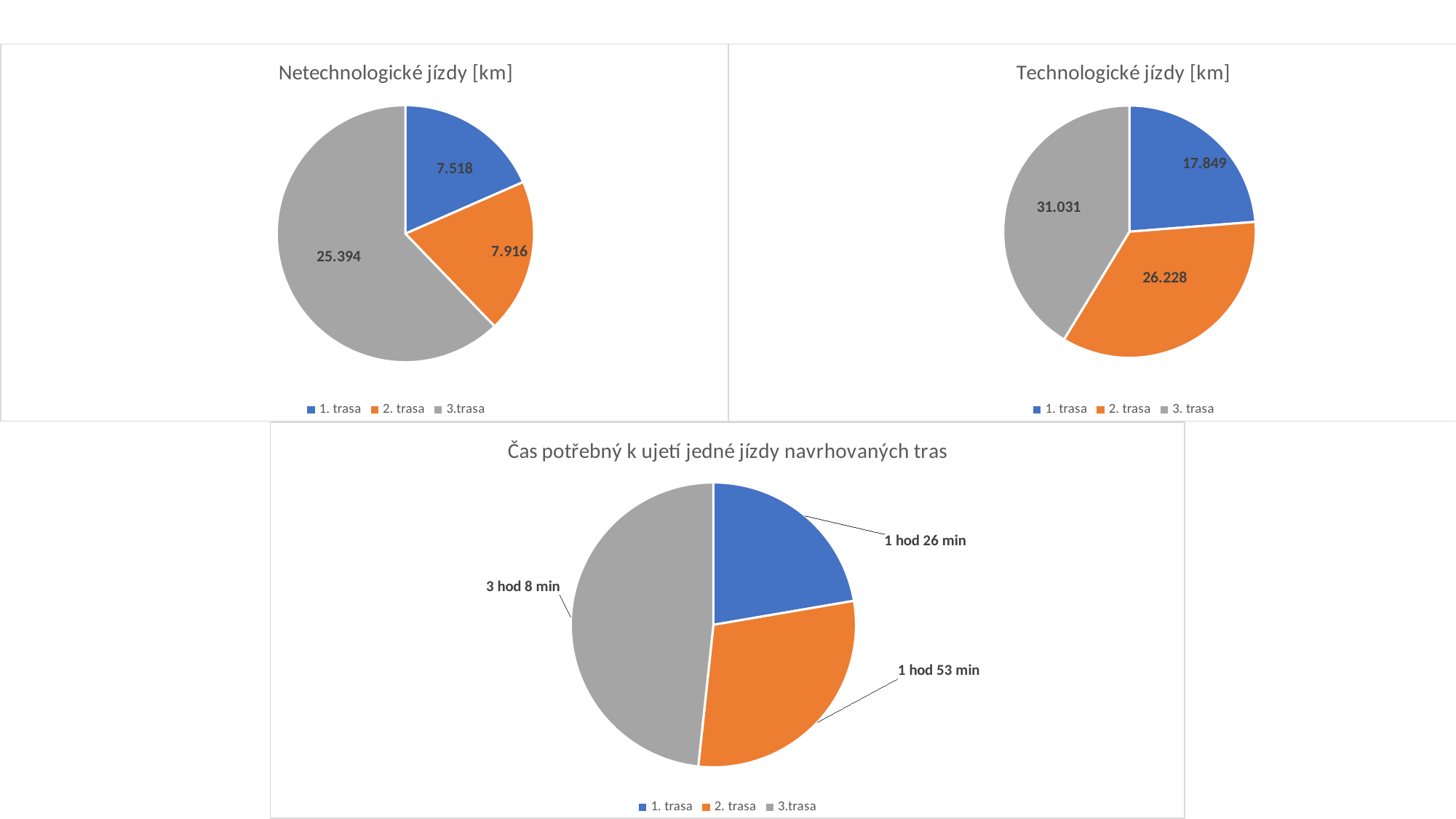
What kind of chart is the chart titled 'Netechnologické jízdy [km]'? pie chart In the chart titled 'Technologické jízdy [km]', what is the value for 3. trasa? 31.031 In the chart titled 'Čas potřebný k ujetí jedné jízdy navrhovaných tras', what is the value for 3.trasa? 3 hod 8 min In the chart titled 'Netechnologické jízdy [km]', what is the value for 3.trasa? 25.394 In the chart titled 'Čas potřebný k ujetí jedné jízdy navrhovaných tras', which category has the largest slice? 3.trasa In the chart titled 'Technologické jízdy [km]', what is the value for 2. trasa? 26.228 In the chart titled 'Technologické jízdy [km]', which category has the smallest slice? 1. trasa How many categories does the legend of the chart titled 'Čas potřebný k ujetí jedné jízdy navrhovaných tras' list? 3 In the chart titled 'Netechnologické jízdy [km]', what is the value for 1. trasa? 7.518 In the chart titled 'Technologické jízdy [km]', which is larger: the value for 2. trasa or the value for 1. trasa? 2. trasa In the chart titled 'Netechnologické jízdy [km]', which category has the largest slice? 3.trasa In the chart titled 'Čas potřebný k ujetí jedné jízdy navrhovaných tras', what is the value for 1. trasa? 1 hod 26 min